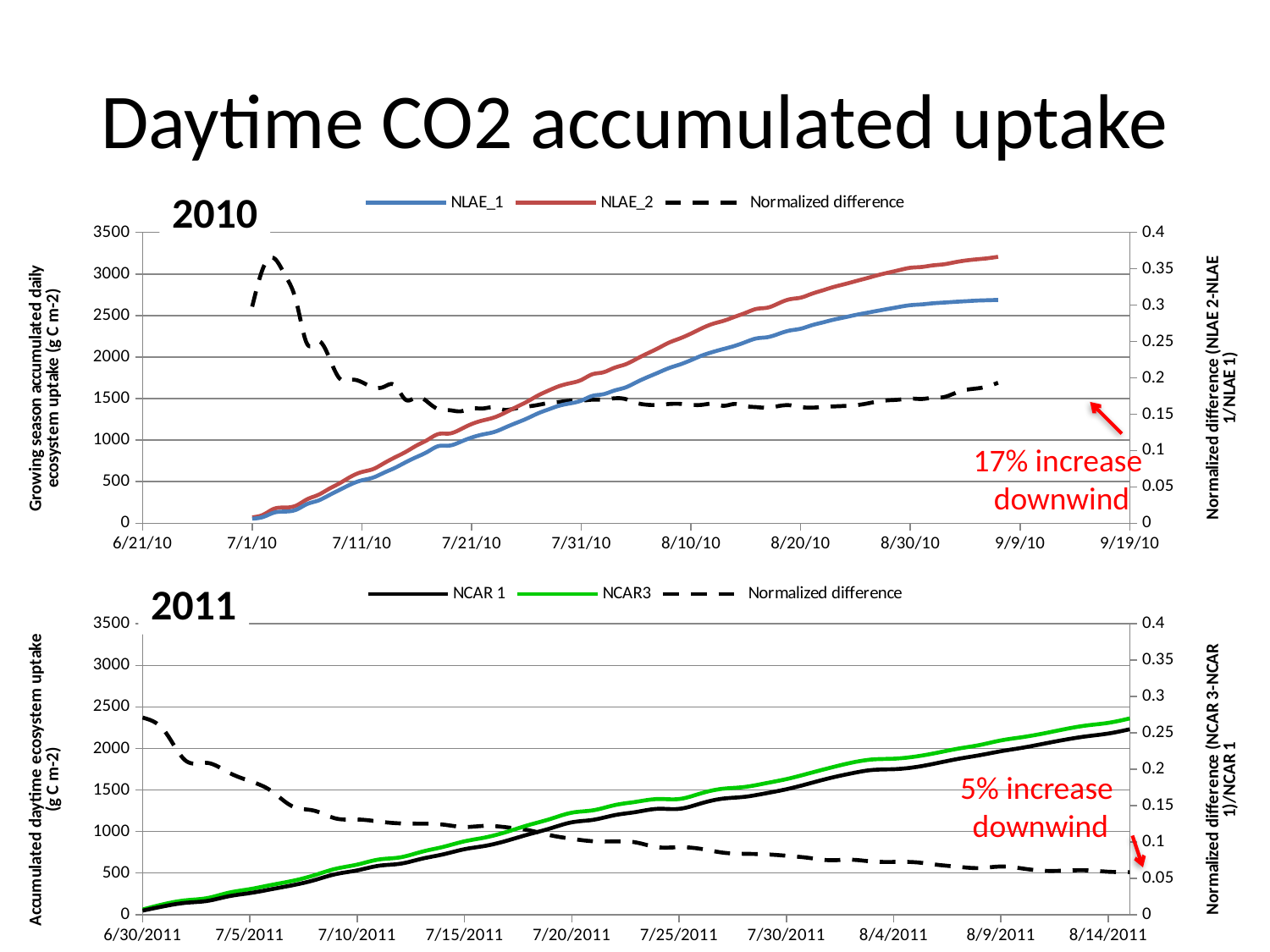
In the 2011 chart, which series is higher at the end of the period, NCAR 1 or NCAR3? NCAR3 What percentage increase downwind is annotated on the 2010 chart? 17% In the 2011 chart, is the final value of NCAR3 greater or less than 2500? less In the 2011 chart, which legend entry is drawn as a dashed line? Normalized difference How many series does the legend of the 2010 chart list? 3 In the 2010 chart, is the final value of NLAE_1 greater or less than 3000? less In the 2011 chart, does the Normalized difference series rise or fall along the x axis? fall How many series does the legend of the 2011 chart list? 3 In the 2010 chart, which series is higher at the end of the period, NLAE_1 or NLAE_2? NLAE_2 In the 2010 chart, is the final value of NLAE_2 greater or less than 3000? greater What kind of chart is the 2010 chart at the top of the slide? line chart In the 2010 chart, does the NLAE_2 series rise or fall along the x axis? rise